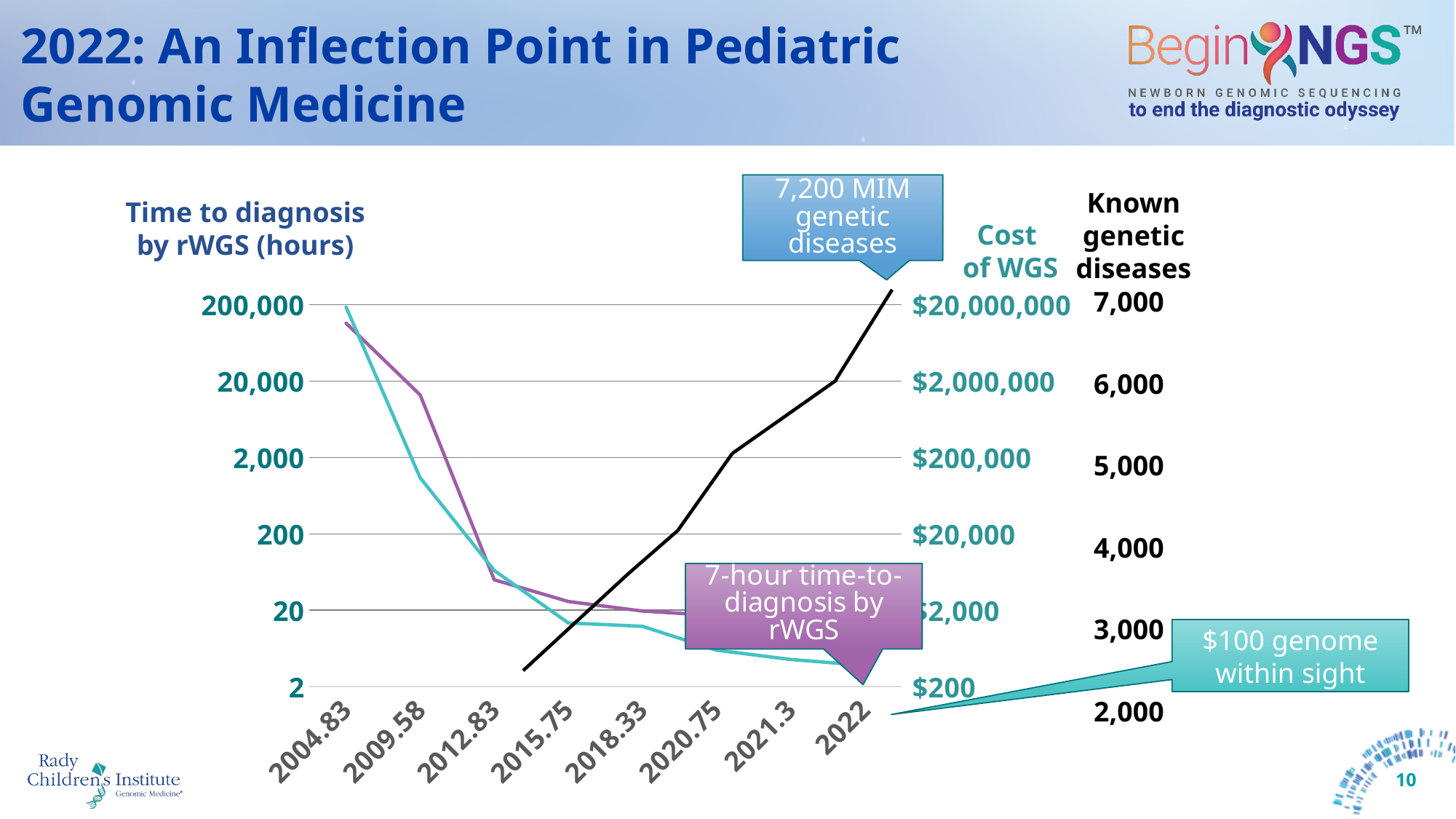
Does the black Known genetic diseases line rise or fall from 2015.75 to 2022? rise Does the purple Time to diagnosis by rWGS line rise or fall from 2004.83 to 2020.75? fall Does the teal Cost of WGS line rise or fall from 2004.83 to 2022? fall Is the Known genetic diseases value at 2015.75 greater or less than 3,000? less What is the first year label on the x axis of the chart? 2004.83 What kind of chart is shown on the slide? line chart What is the last year label on the x axis of the chart? 2022 Is the Cost of WGS value at 2009.58 greater or less than $200,000? less Is the Time to diagnosis by rWGS value at 2012.83 greater or less than 200 hours? less How many year labels are shown along the x axis of the chart? 8